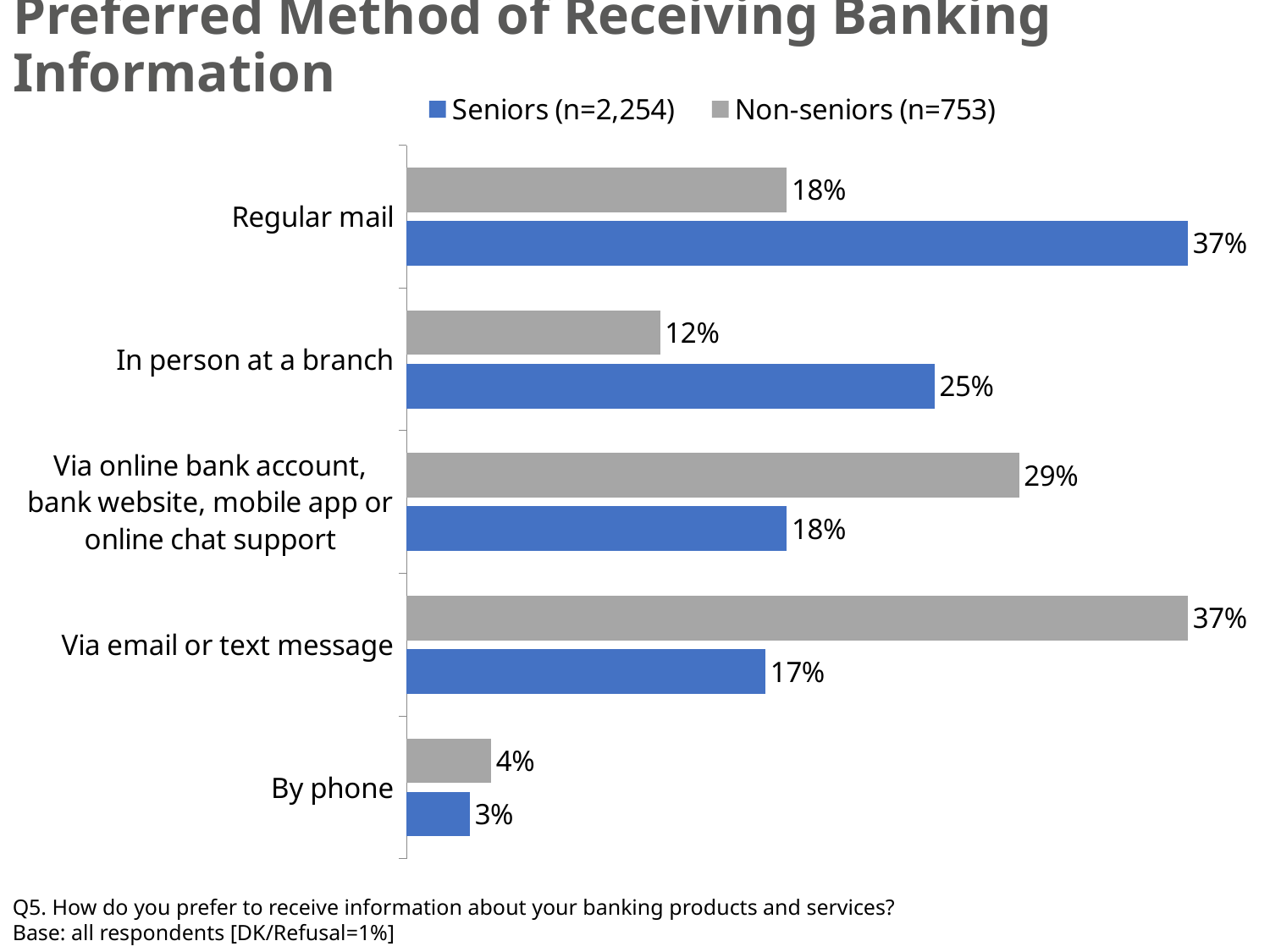
What percentage of non-seniors prefer receiving banking information in person at a branch? 12% What kind of chart is shown on the slide? Bar chart Which group has the larger value for via online bank account, bank website, mobile app or online chat support? Non-seniors (n=753) What percentage of non-seniors prefer receiving banking information via email or text message? 37% What percentage of seniors prefer receiving banking information by regular mail? 37% How many methods of receiving banking information are shown on the chart? 5 What is the difference between non-seniors and seniors for via email or text message? 20% What colour represents the Seniors series? Blue Which method has the lowest value for non-seniors? By phone Which method has the highest value for seniors? Regular mail How many series does the legend list? 2 What is the difference between seniors and non-seniors for regular mail? 19%